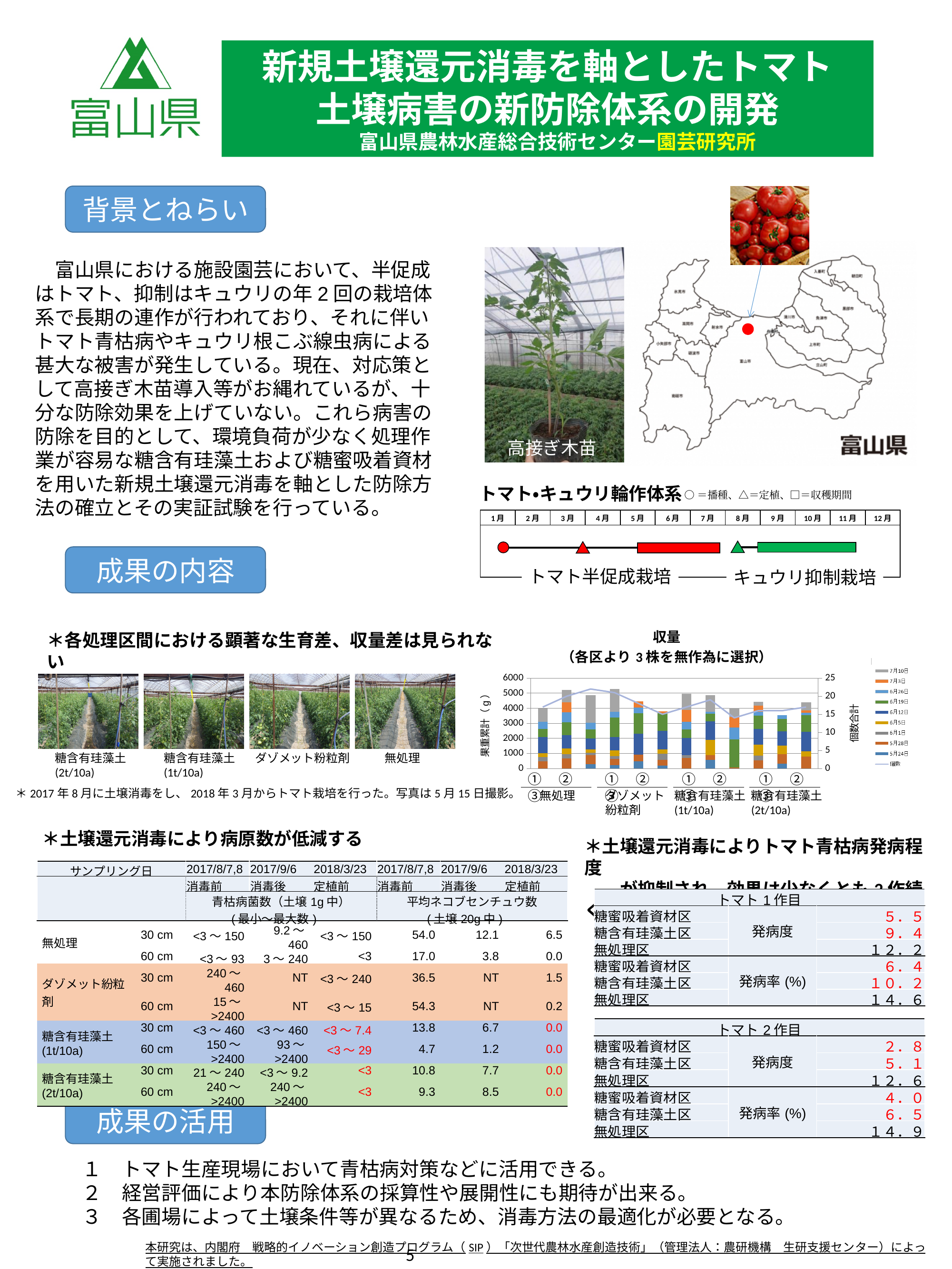
In the 収量 chart, which bar is taller for ダゾメット粉粒剤: ① or ③? ① In the 収量 chart, is the total for bar ① of ダゾメット粉粒剤 greater or less than 4000? greater What is the maximum value shown on the left axis of the 収量 chart? 6000 In the 収量 chart, is the total for bar ① of 無処理 greater or less than 5000? less What is the title of the chart on the right side of the slide? 収量（各区より3株を無作為に選択） In the 収量 chart, is the total for bar ③ of ダゾメット粉粒剤 greater or less than 4000? less How many treatment groups are shown along the x axis of the 収量 chart? 4 What is the label of the left vertical axis of the 収量 chart? 果重累計（g） In the 収量 chart, which bar is taller for 無処理: ① or ②? ② What kind of chart is the 収量 chart on the slide? combination bar and line chart (stacked bars with a line) How many bars are plotted in the 収量 chart? 12